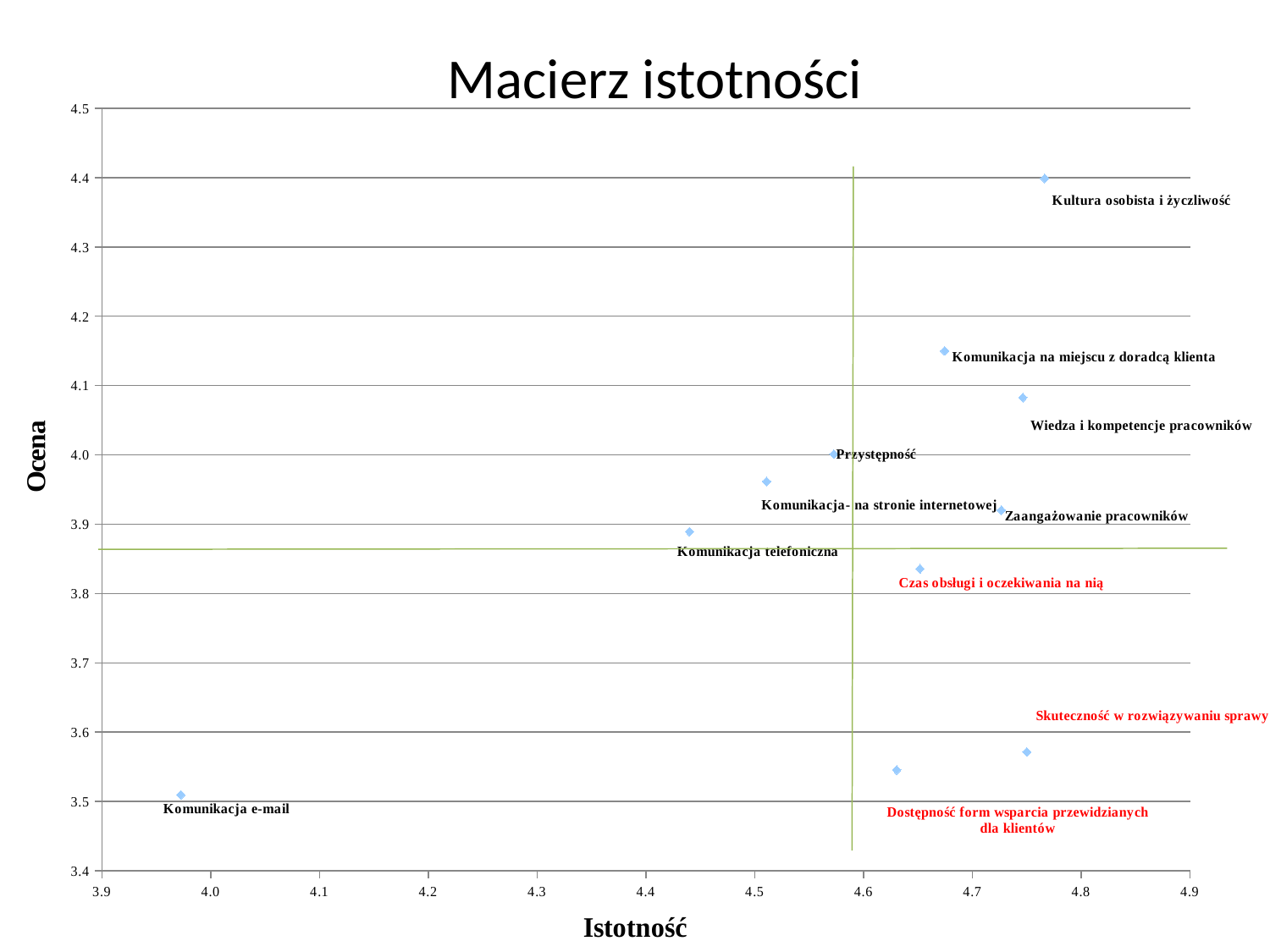
Which point has the lowest Ocena value? Komunikacja e-mail How many data points are plotted on the chart? 11 Is the Istotność value for Komunikacja e-mail greater or less than 4.0? less Which point has the highest Ocena value? Kultura osobista i życzliwość Which point has the lowest Istotność value? Komunikacja e-mail Which has the higher Ocena value: Komunikacja telefoniczna or Komunikacja- na stronie internetowej? Komunikacja- na stronie internetowej Is the Ocena value for Skuteczność w rozwiązywaniu sprawy greater or less than 3.6? less What kind of chart is shown on the slide? scatter chart What is the title of the chart? Macierz istotności What are the titles of the x axis and the y axis? Istotność (x) and Ocena (y) Which has the higher Ocena value: Komunikacja na miejscu z doradcą klienta or Wiedza i kompetencje pracowników? Komunikacja na miejscu z doradcą klienta Is the Ocena value for Komunikacja na miejscu z doradcą klienta greater or less than 4.1? greater